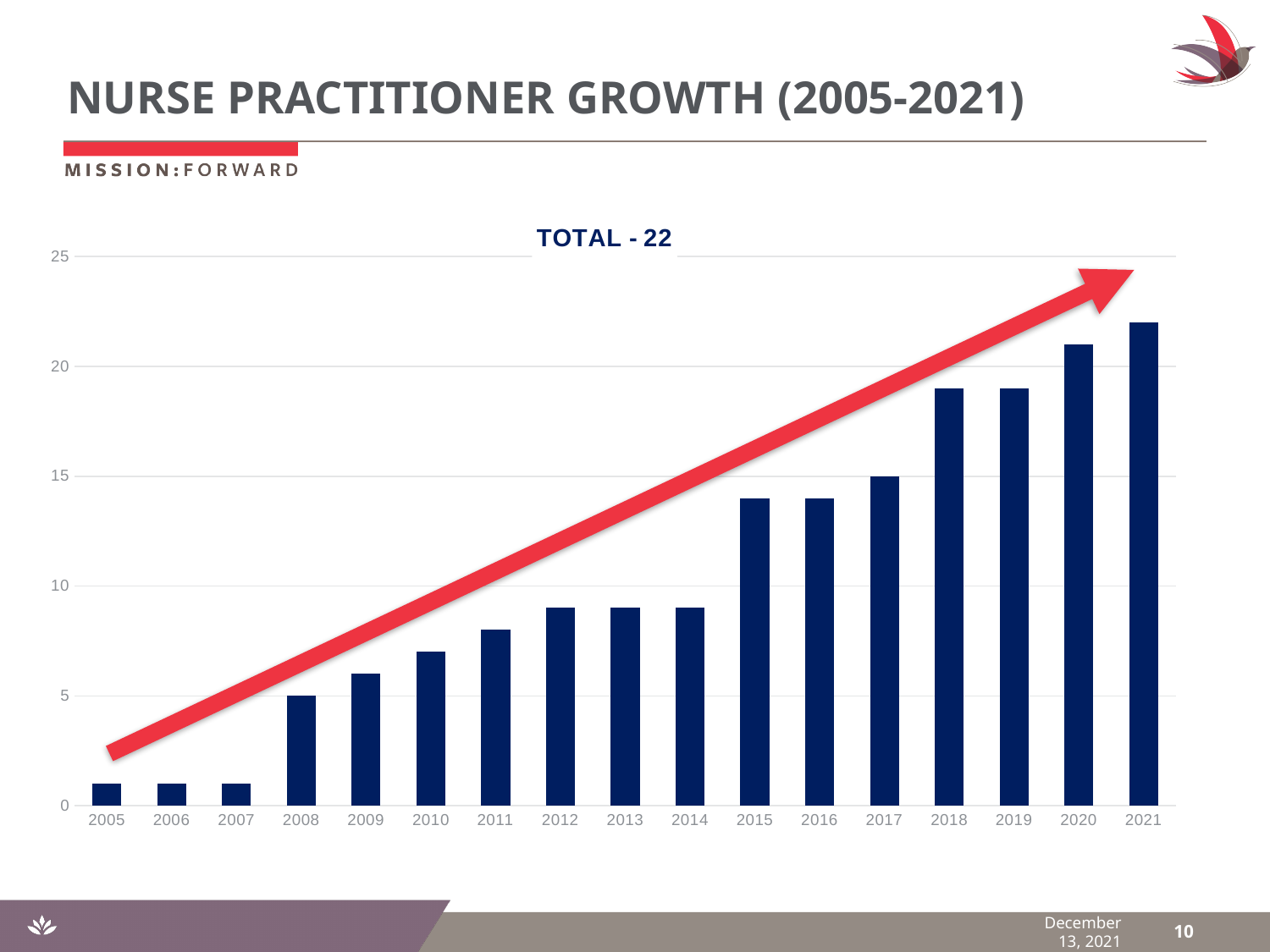
Is the value for 2005 greater or less than 5? less What is the value for 2008? 5 Is the value for 2012 greater or less than 10? less Is the value for 2021 greater or less than 20? greater Do the values generally rise or fall from 2005 to 2021? rise Which is larger, the value for 2015 or the value for 2010? 2015 What kind of chart is shown on the slide? bar chart What is the title shown above the chart? TOTAL - 22 What is the value for 2017? 15 How many years are shown on the x axis of the chart? 17 Which year has the highest bar in the chart? 2021